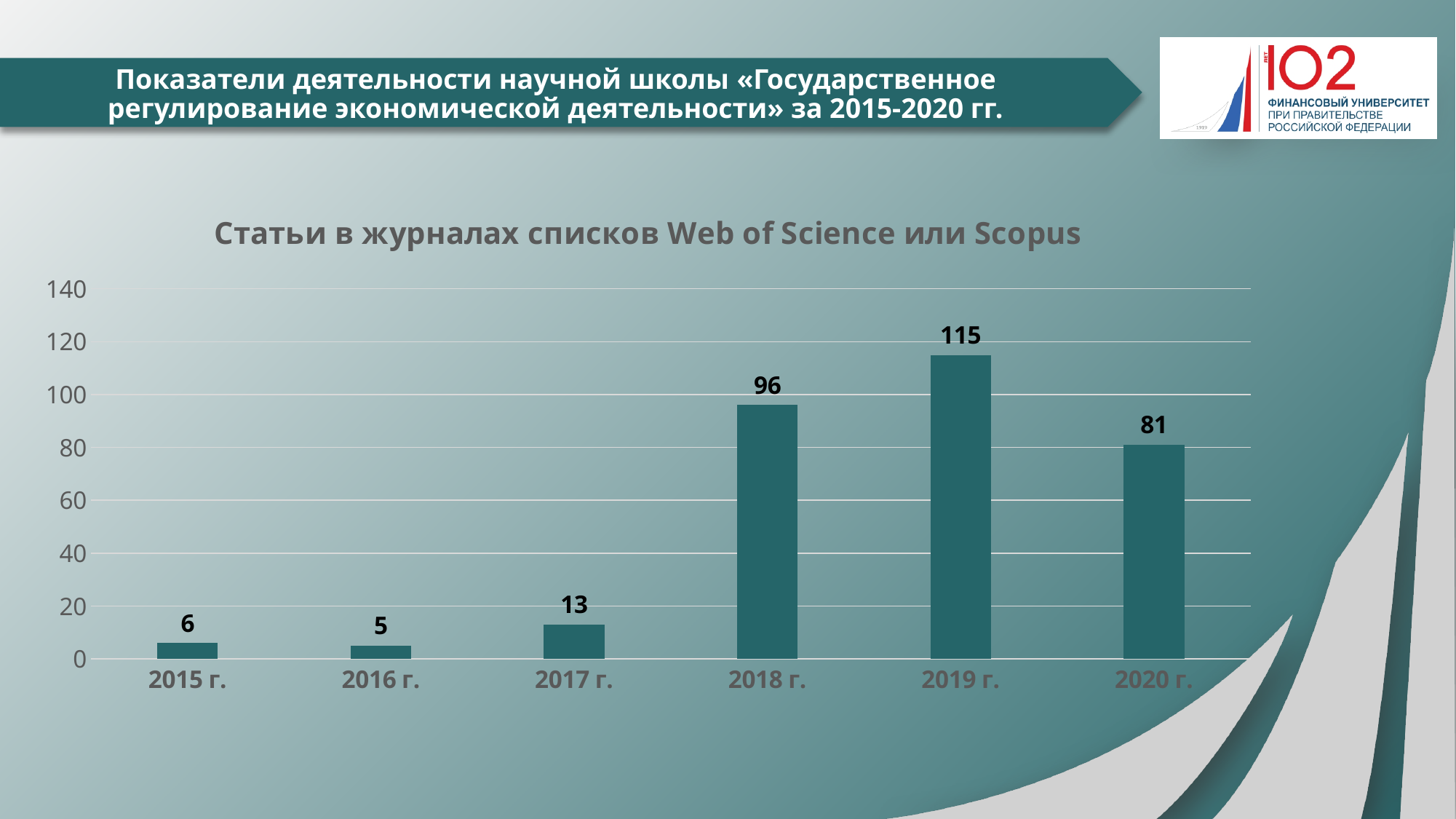
What is the value for 2018 г.? 96 How many years are shown on the x axis? 6 Which year has the lowest value? 2016 г. What is the title of the chart? Статьи в журналах списков Web of Science или Scopus What is the difference between the values for 2019 г. and 2020 г.? 34 Which is larger, the value for 2017 г. or the value for 2015 г.? 2017 г. Is the value for 2019 г. greater or less than 100? greater Which year has the highest value? 2019 г. What is the value for 2015 г.? 6 What kind of chart is shown on the slide? bar chart What is the difference between the values for 2018 г. and 2017 г.? 83 What is the value for 2020 г.? 81